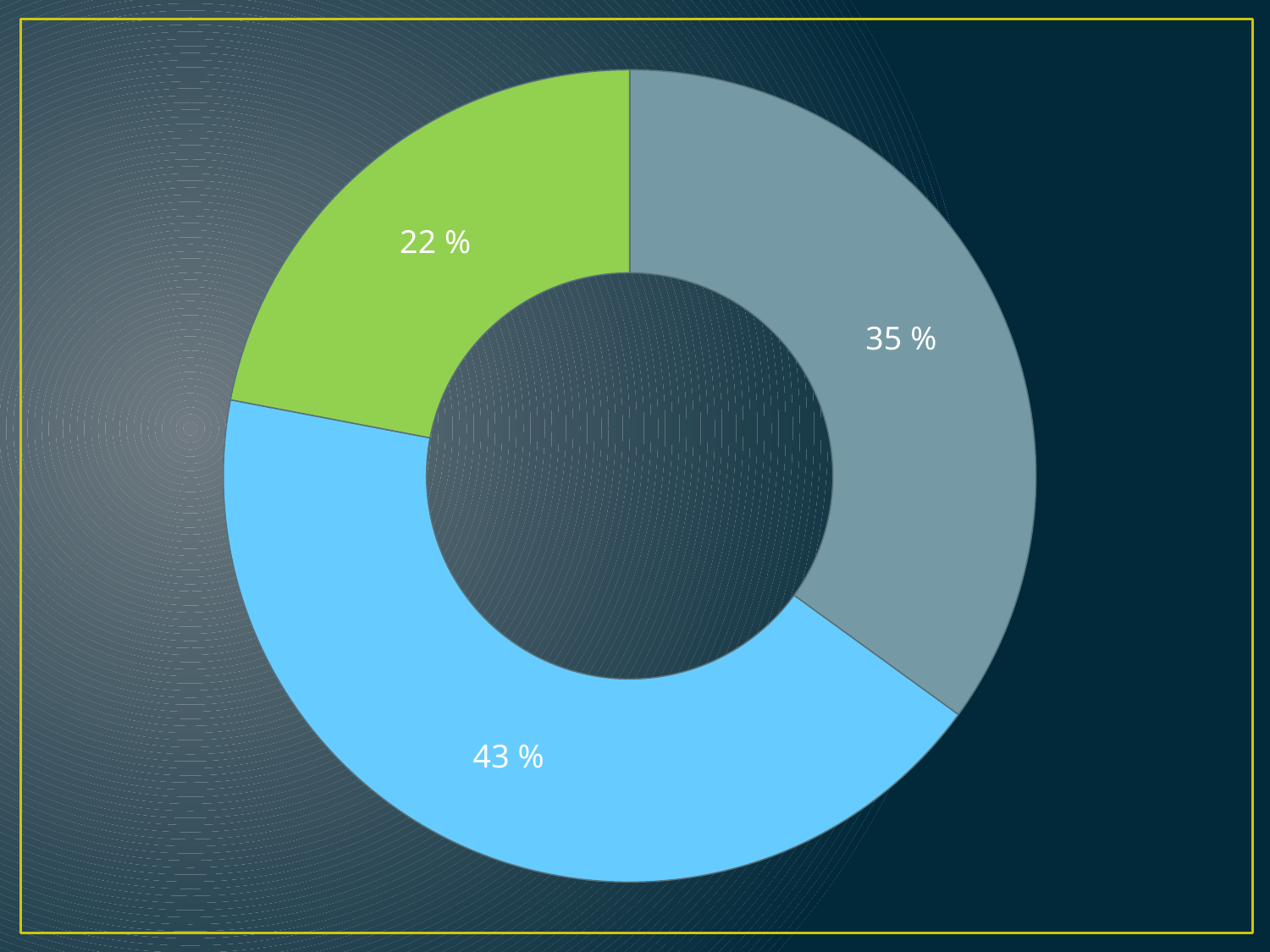
Which slice has the largest share? the light blue slice (43 %) How many slices does the doughnut chart have? 3 Which is larger, the grey-blue slice or the light blue slice? the light blue slice Does the chart display a legend? No What percentage is shown on the green slice? 22 % What is the difference between the grey-blue slice and the green slice? 13 % Which slice has the smallest share? the green slice (22 %) What is the difference between the light blue slice and the green slice? 21 % What percentage is shown on the light blue slice? 43 % What is the combined share of the green and grey-blue slices? 57 % What percentage is shown on the grey-blue slice? 35 % What kind of chart is shown on the slide? doughnut chart